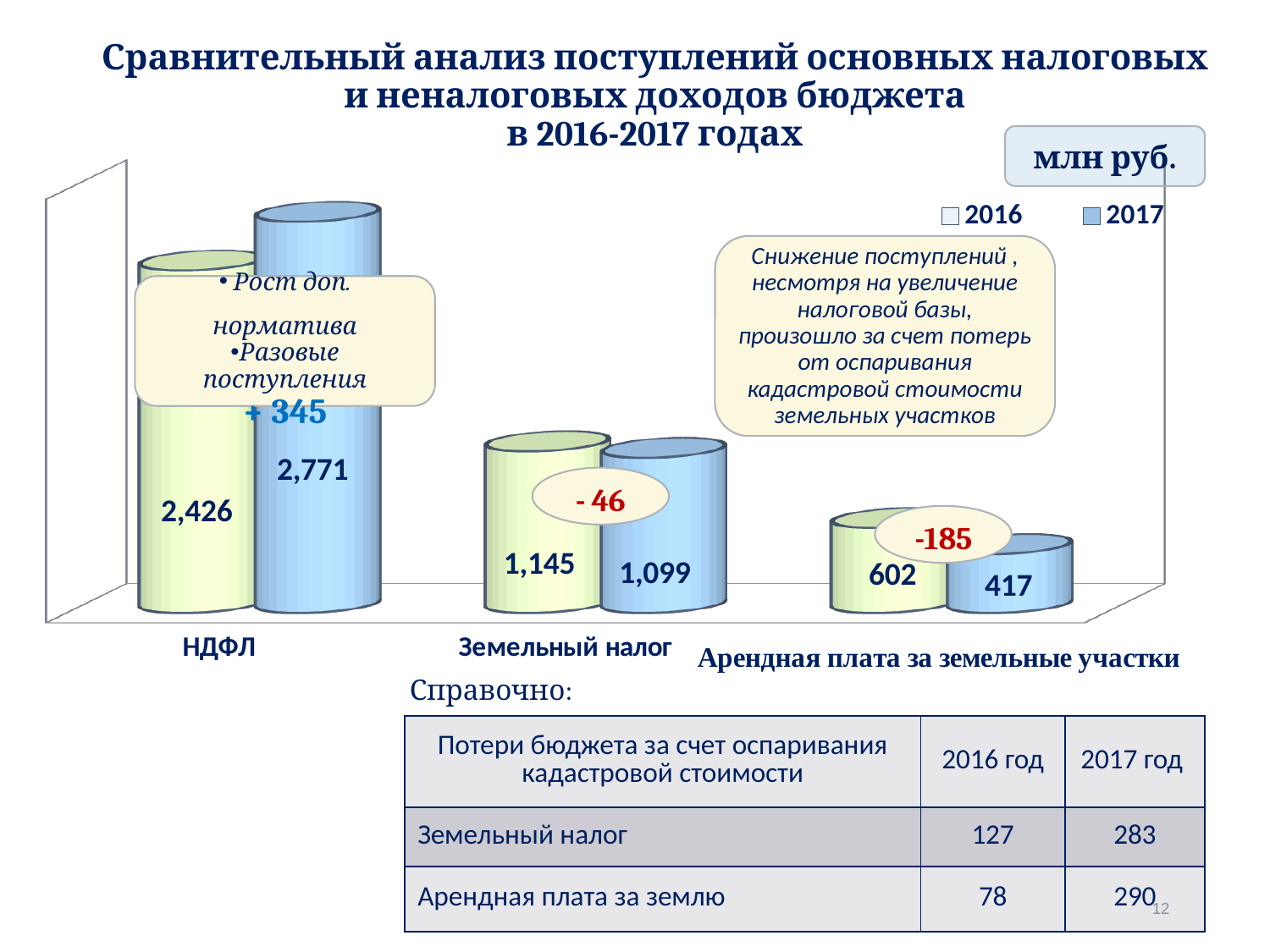
What is the 2017 value for НДФЛ? 2,771 What is the 2016 value for Земельный налог? 1,145 What is the 2017 value for Арендная плата за земельные участки? 417 What is the difference between the 2017 and 2016 values for НДФЛ? 345 How many categories are shown on the chart? 3 Which is larger for Арендная плата за земельные участки, the 2016 value or the 2017 value? 2016 What is the difference between the 2016 and 2017 values for Земельный налог? 46 Which category has the lowest 2016 value? Арендная плата за земельные участки How many series does the legend list? 2 Which category has the highest 2017 value? НДФЛ What is the 2016 value for Арендная плата за земельные участки? 602 What kind of chart is shown on the slide? Bar chart